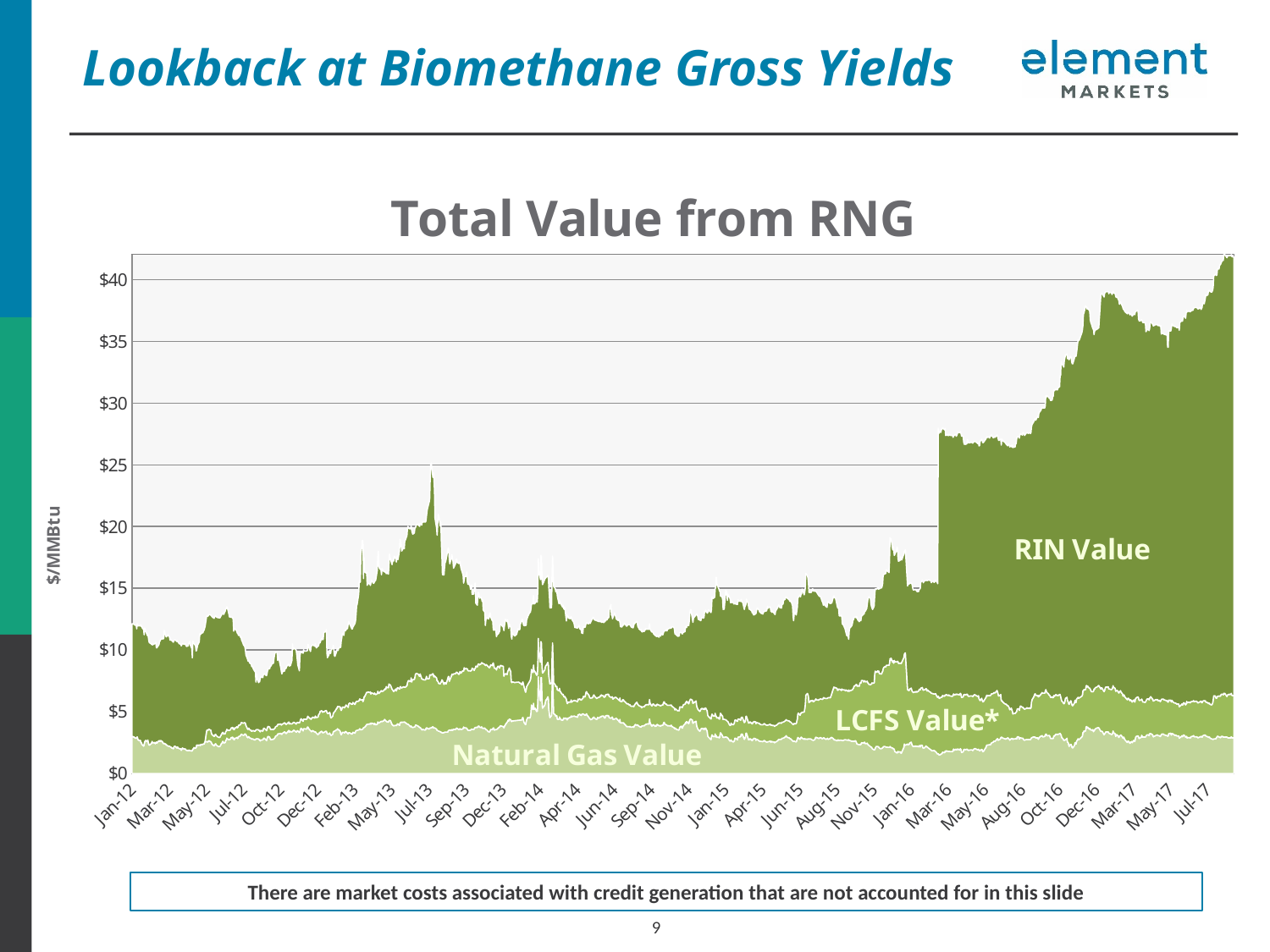
What kind of chart is shown on the slide? area chart How many series are labeled on the chart? 3 Is the total value at Mar-16 greater or less than $25? greater Which is larger, the total value at Jul-17 or at Jan-12? Jul-17 Is the Natural Gas Value at Jan-12 greater or less than $5? less At which x-axis date does the total value reach its highest point? Jul-17 Is the total value at Jan-12 greater or less than $15? less What is the title of the chart? Total Value from RNG Does the total value generally rise or fall from Jan-12 to Jul-17? rise Which series forms the bottom layer of the stacked area chart? Natural Gas Value